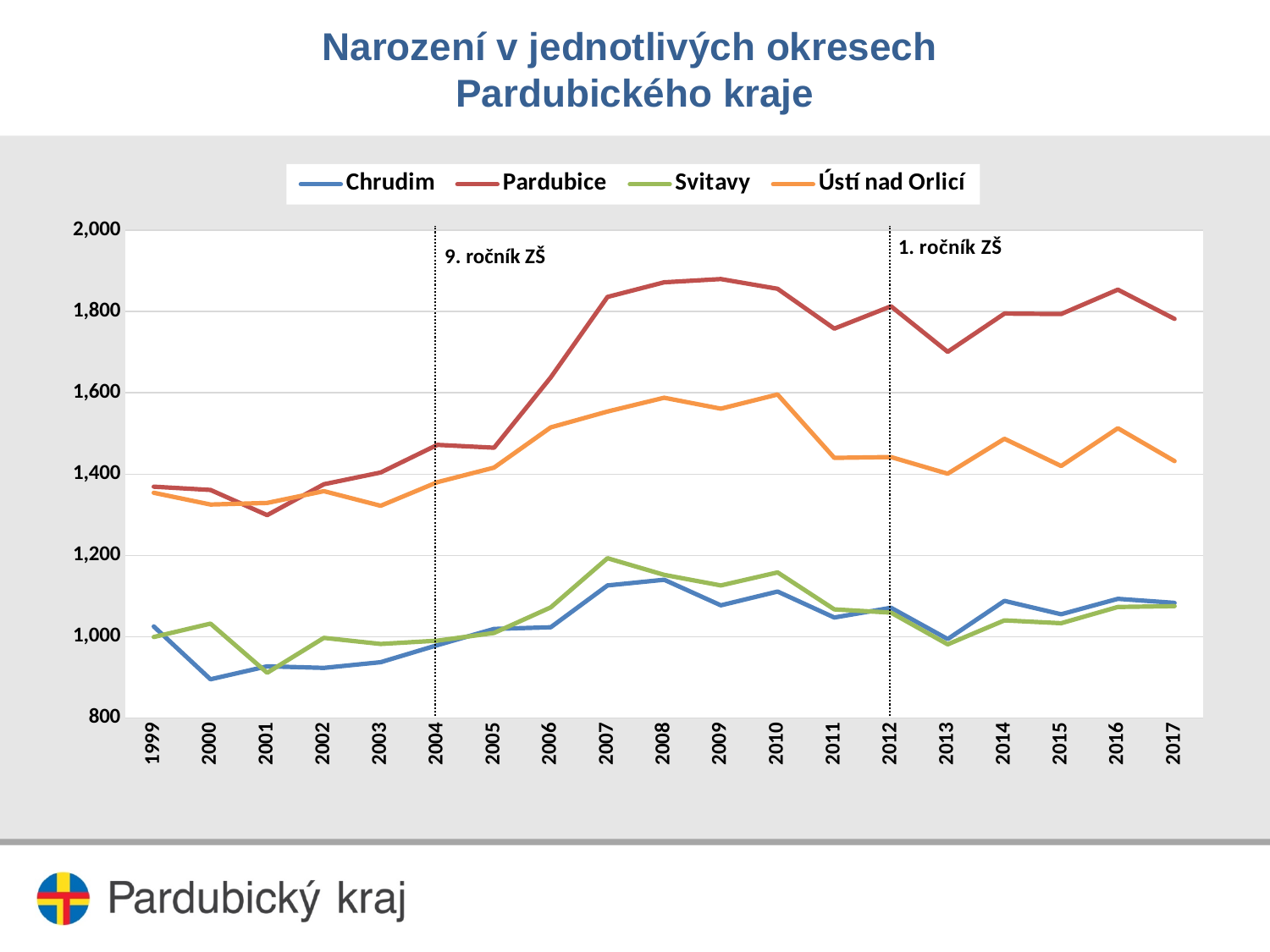
Which district had the highest number of births in 2010? Pardubice Does the Pardubice line rise or fall between 2004 and 2009? rise What kind of chart is shown on the slide? line chart Which district had the lowest number of births in 2000? Chrudim How many series does the legend list? 4 Is the value for Chrudim in 2000 greater or less than 1,000? less In 2007, which is larger: the value for Pardubice or the value for Ústí nad Orlicí? Pardubice Is the value for Pardubice in 2008 greater or less than 1,800? greater How many years are plotted along the x axis? 19 Is the value for Ústí nad Orlicí in 2010 greater or less than 1,400? greater What label is attached to the vertical dotted line at 2012? 1. ročník ZŠ Does the Ústí nad Orlicí line rise or fall between 2010 and 2011? fall